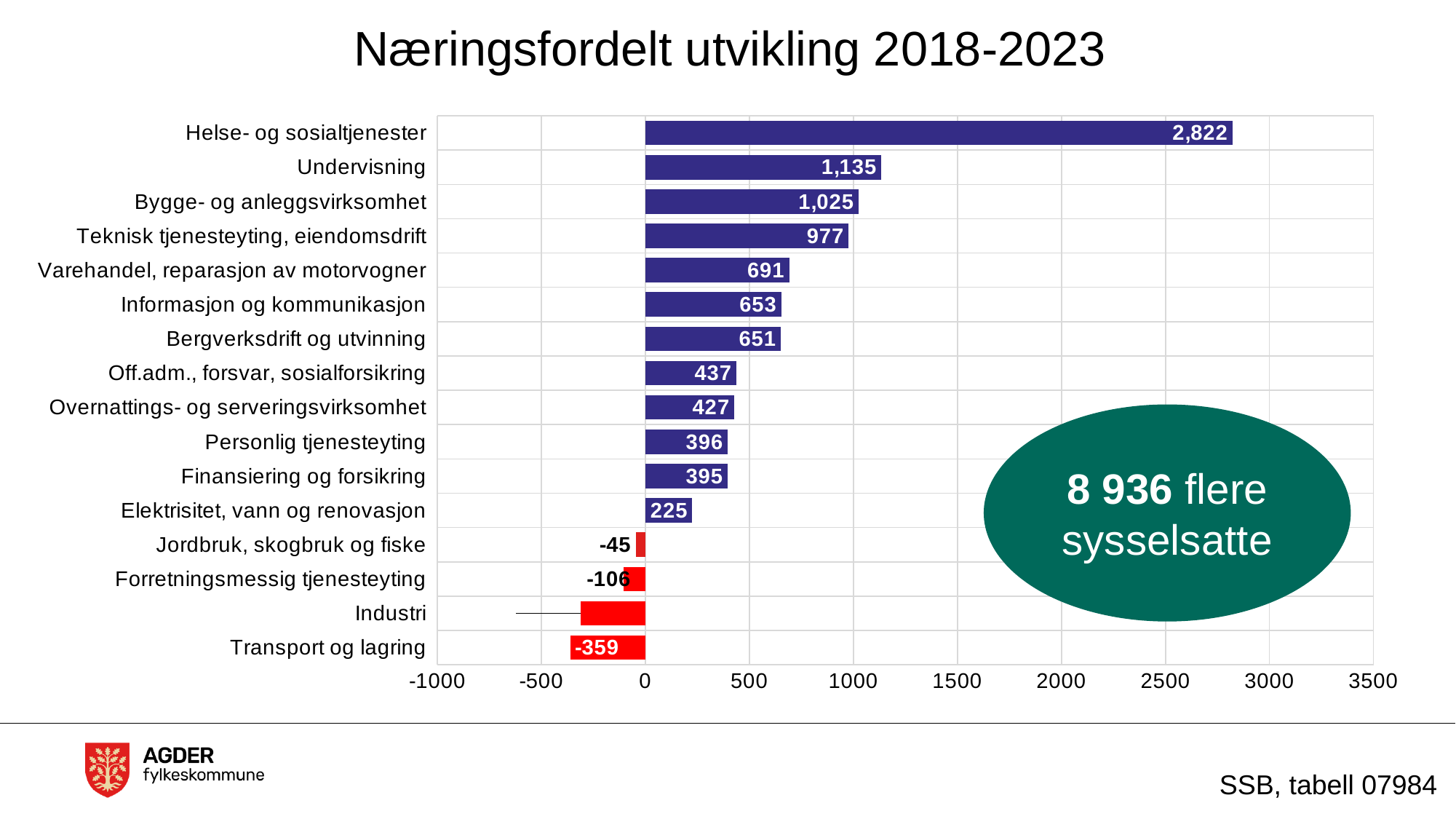
What is the difference between the values for Helse- og sosialtjenester and Undervisning? 1,687 Which category has the highest value? Helse- og sosialtjenester What is the value for Helse- og sosialtjenester? 2,822 How many categories are shown in the chart? 16 What is the value for Forretningsmessig tjenesteyting? -106 What kind of chart is shown on the slide? bar chart What is the value for Transport og lagring? -359 Which is larger, the value for Varehandel, reparasjon av motorvogner or the value for Off.adm., forsvar, sosialforsikring? Varehandel, reparasjon av motorvogner What is the title of the chart? Næringsfordelt utvikling 2018-2023 Is the value for Industri greater or less than -500? greater What is the value for Elektrisitet, vann og renovasjon? 225 Which category has the lowest value? Transport og lagring